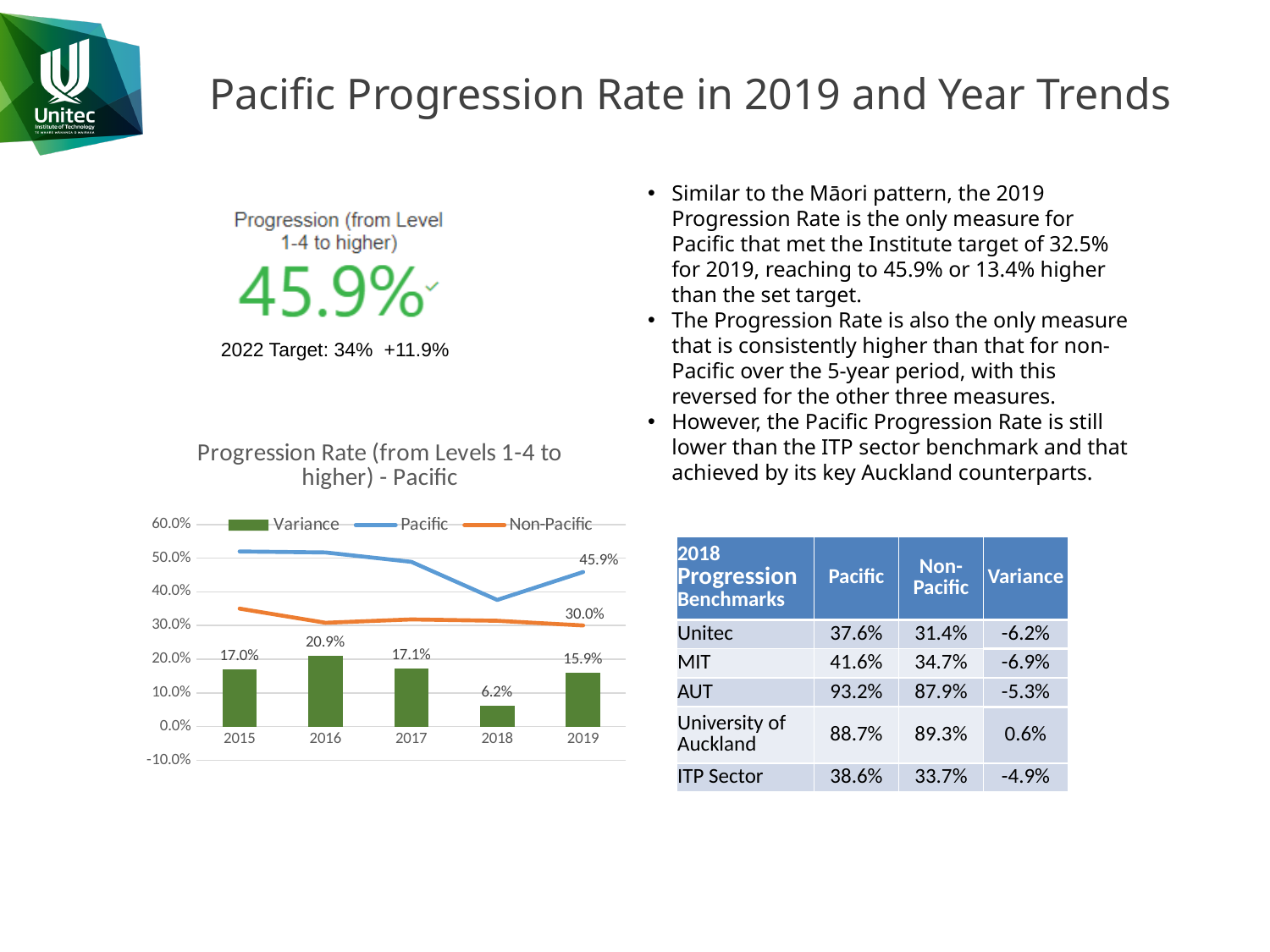
In the Progression Rate chart, is the Pacific value for 2018 greater or less than 40.0%? less In the Progression Rate chart, which year has the highest Variance? 2016 In the Progression Rate chart, is the Variance larger in 2016 or in 2019? 2016 In the Progression Rate chart, what is the Variance value for 2018? 6.2% In the Progression Rate chart, what is the difference between the Variance in 2016 and the Variance in 2018? 14.7% In the Progression Rate chart, what is the Pacific value for 2019? 45.9% In the Progression Rate (from Levels 1-4 to higher) - Pacific chart, what is the Variance value for 2016? 20.9% How many series does the legend of the Progression Rate chart list? 3 In the Progression Rate chart, which year has the lowest Variance? 2018 In the Progression Rate chart, what is the Non-Pacific value for 2019? 30.0% In the Progression Rate chart, is the Pacific value for 2015 greater or less than 50.0%? greater In the Progression Rate chart, what is the difference between the Pacific and Non-Pacific values in 2019? 15.9%